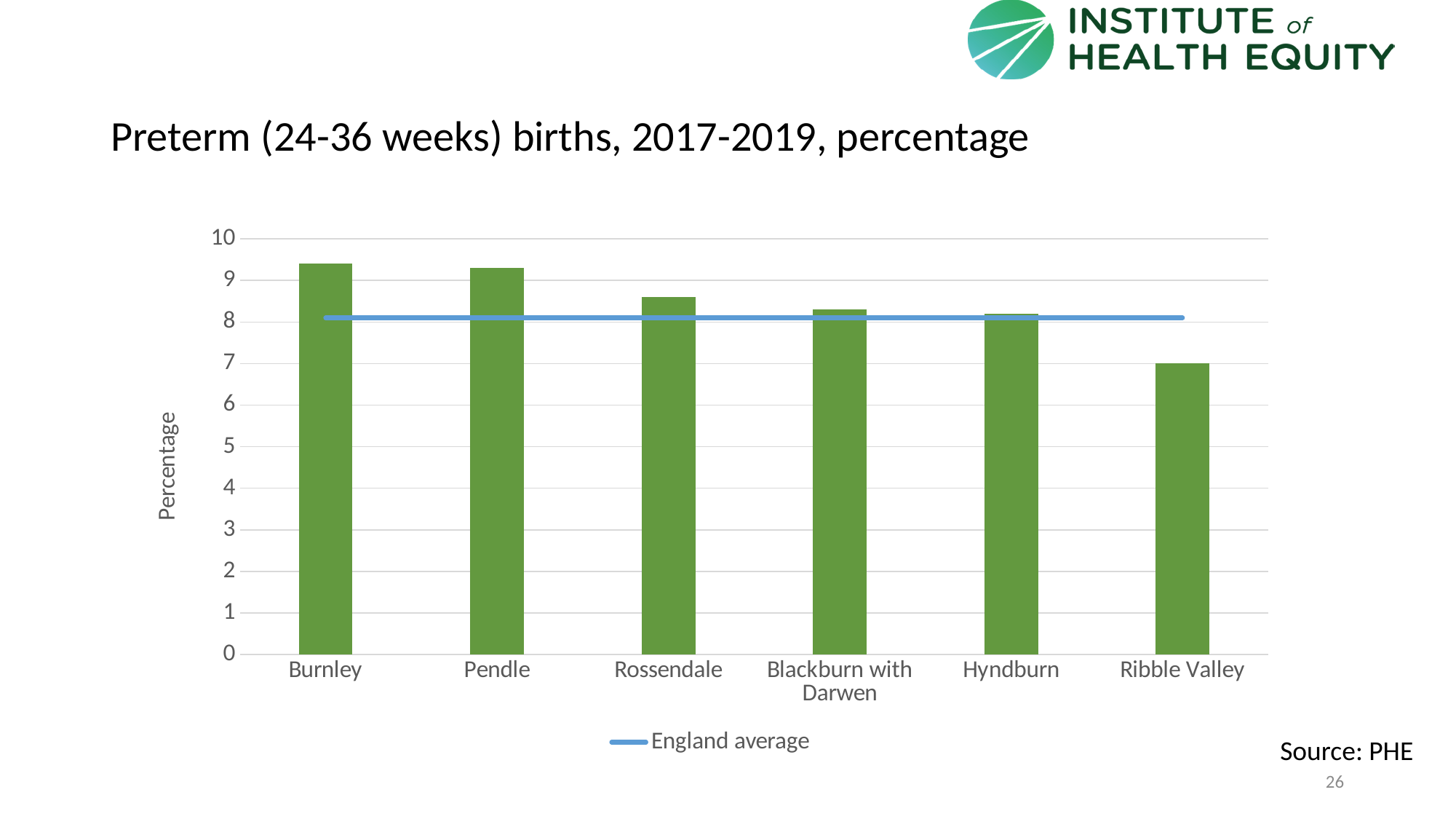
Which area has the lowest preterm birth percentage? Ribble Valley Is the value for Burnley greater or less than 9? greater Is the value for Hyndburn greater or less than 9? less Is the value for Rossendale greater or less than 8? greater Which has the higher preterm birth percentage, Pendle or Ribble Valley? Pendle What kind of chart is shown on the slide? bar chart How many local areas are shown on the x axis of the chart? 6 Which has the higher preterm birth percentage, Burnley or Rossendale? Burnley How many entries does the chart legend list? 1 What is the title of the chart? Preterm (24-36 weeks) births, 2017-2019, percentage Do the bar values rise or fall from left to right across the x axis? fall